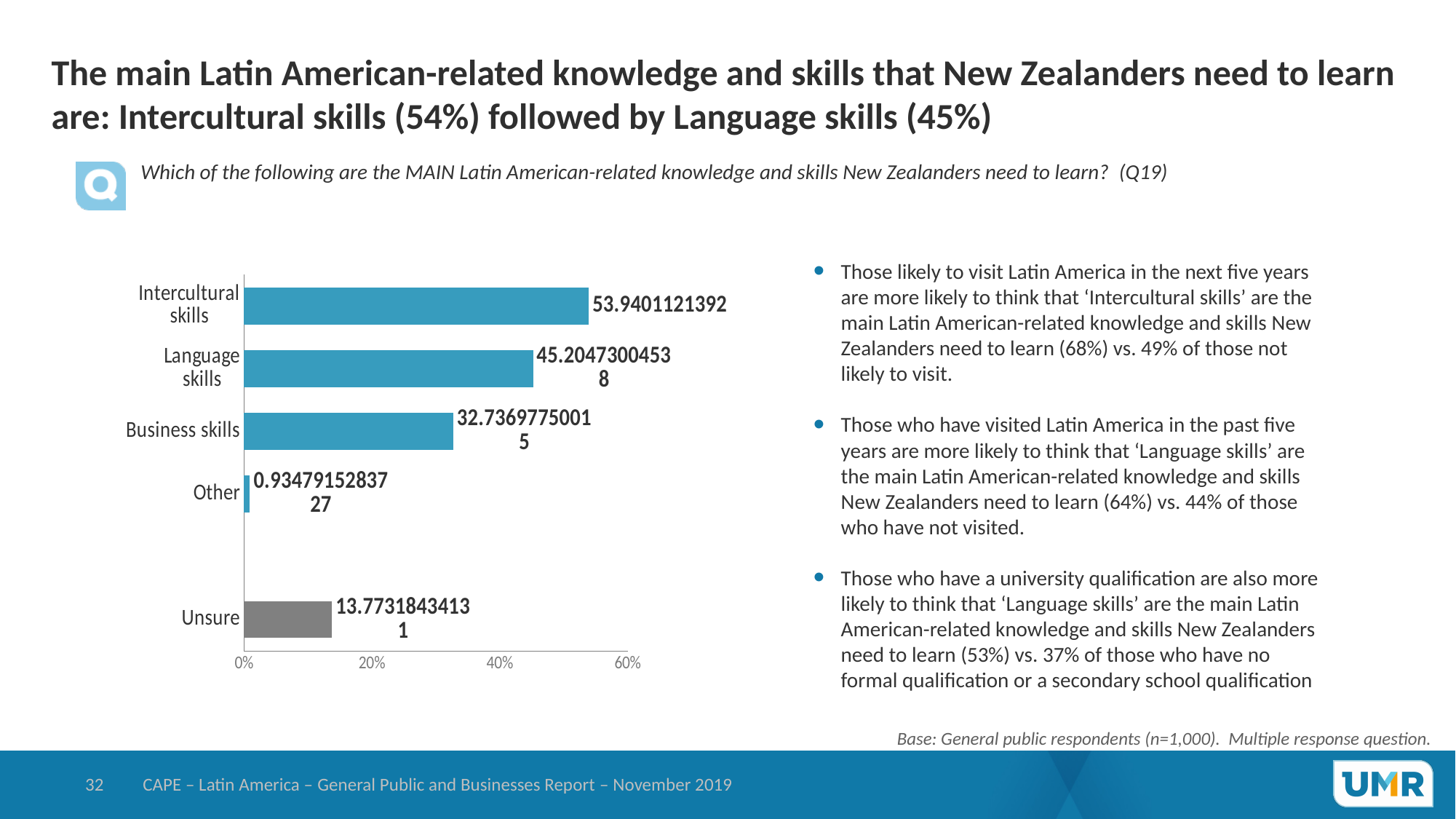
Is the value for Language skills greater or less than 40%? greater Which is larger, the value for Unsure or the value for Other? Unsure What is the data label shown for Intercultural skills? 53.9401121392 Which category has the lowest value in the chart? Other Which bar in the chart is coloured grey rather than blue? Unsure Which is larger, the value for Language skills or the value for Business skills? Language skills What is the data label shown for Business skills? 32.73697750015 Which category has the highest value in the chart? Intercultural skills Is the value for Unsure greater or less than 20%? less What is the data label shown for Unsure? 13.77318434131 What type of chart is shown on the slide? bar chart How many categories are plotted in the chart? 5